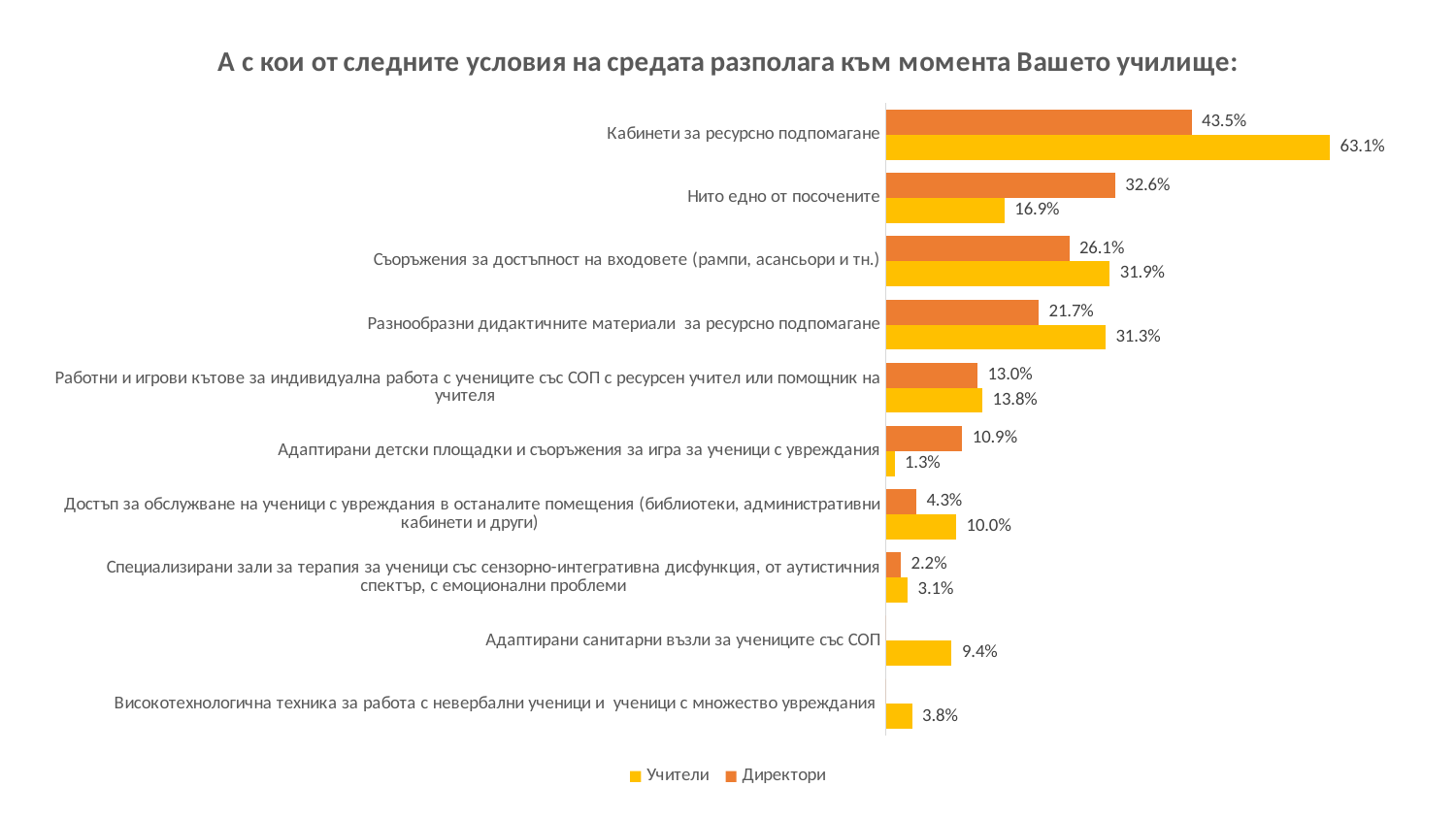
What is the value for Учители for 'Адаптирани санитарни възли за учениците със СОП'? 9.4% How many series does the legend list? 2 Which category has the highest value for Учители? Кабинети за ресурсно подпомагане How many categories are shown on the chart? 10 What is the value for Директори for 'Разнообразни дидактичните материали за ресурсно подпомагане'? 21.7% What is the value for Директори for 'Нито едно от посочените'? 32.6% What is the difference between the Учители and Директори values for 'Кабинети за ресурсно подпомагане'? 19.6% For 'Нито едно от посочените', which series has the larger value, Учители or Директори? Директори What is the value for Учители for 'Кабинети за ресурсно подпомагане'? 63.1% What type of chart is shown on the slide? bar chart Which series is shown in yellow in the legend? Учители Which category has the lowest value for Учители? Адаптирани детски площадки и съоръжения за игра за ученици с увреждания